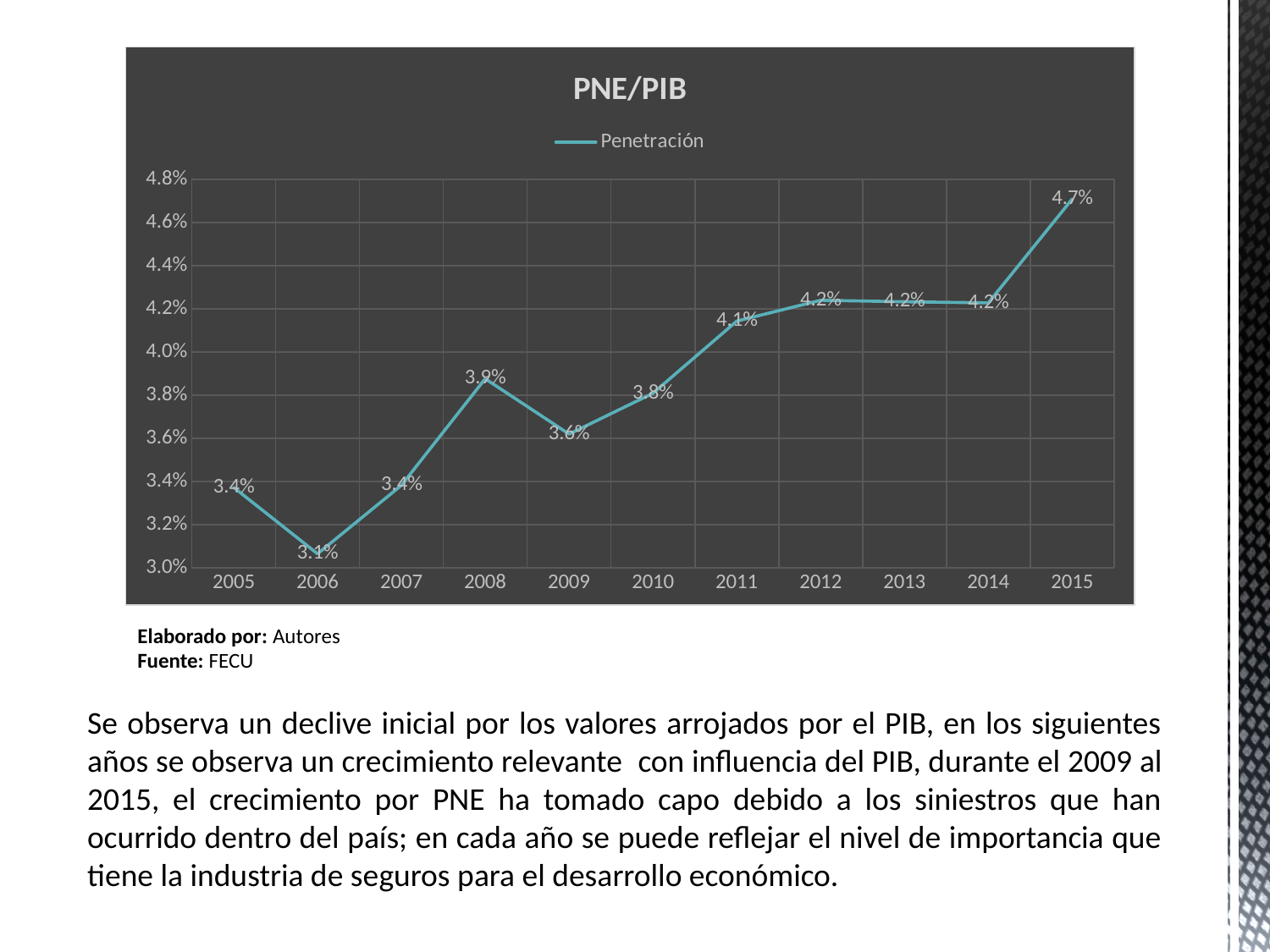
How many years are plotted on the x axis? 11 What is the difference between the Penetración values for 2015 and 2005? 1.3% What is the Penetración value for 2011? 4.1% What is the Penetración value for 2008? 3.9% Which year has the highest Penetración value? 2015 What is the title of the chart? PNE/PIB Which year has the lowest Penetración value? 2006 Which year has a larger Penetración value, 2009 or 2010? 2010 What type of chart is shown on the slide? line chart Does the Penetración value rise or fall from 2009 to 2015? rise How many series does the legend list? 1 What is the Penetración value for 2006? 3.1%